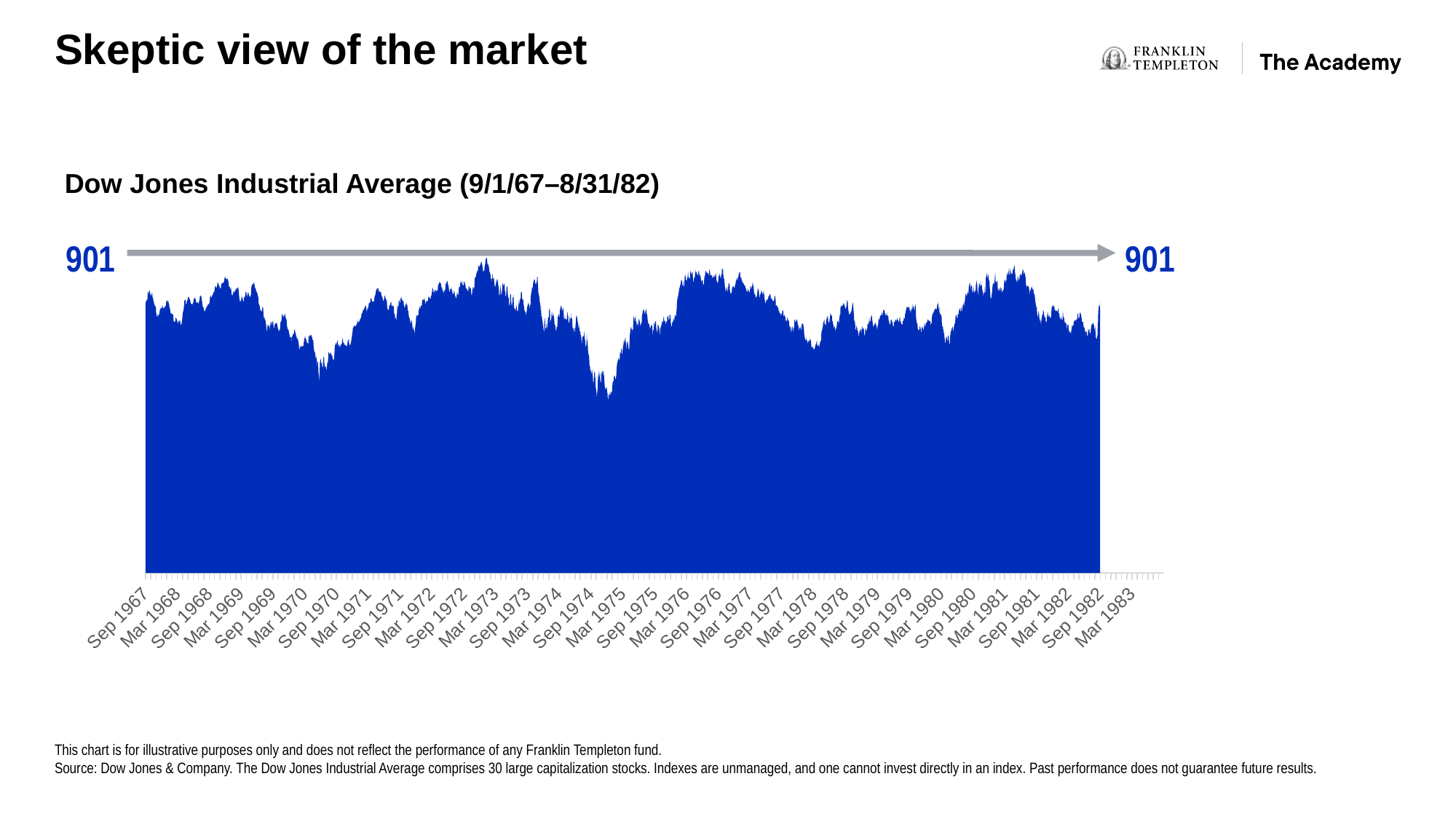
What is the title of the chart? Dow Jones Industrial Average (9/1/67–8/31/82) Is the value printed at the end of the period larger than, smaller than, or equal to the value printed at the start? Equal What is the last label on the x axis? Mar 1983 What value is printed at the end of the series (right side of the chart)? 901 What type of chart is shown on the slide? Area chart What colour is the shaded area of the chart? Blue What value is printed at the start of the series (left side of the chart)? 901 What is the difference between the value printed at the end of the period and the value printed at the start? 0 Over the whole period shown, does the Dow Jones Industrial Average end higher, lower, or at the same level as it started? Same level How many labels are shown on the x axis? 32 What is the first label on the x axis? Sep 1967 In which year does the series reach its lowest point? 1974